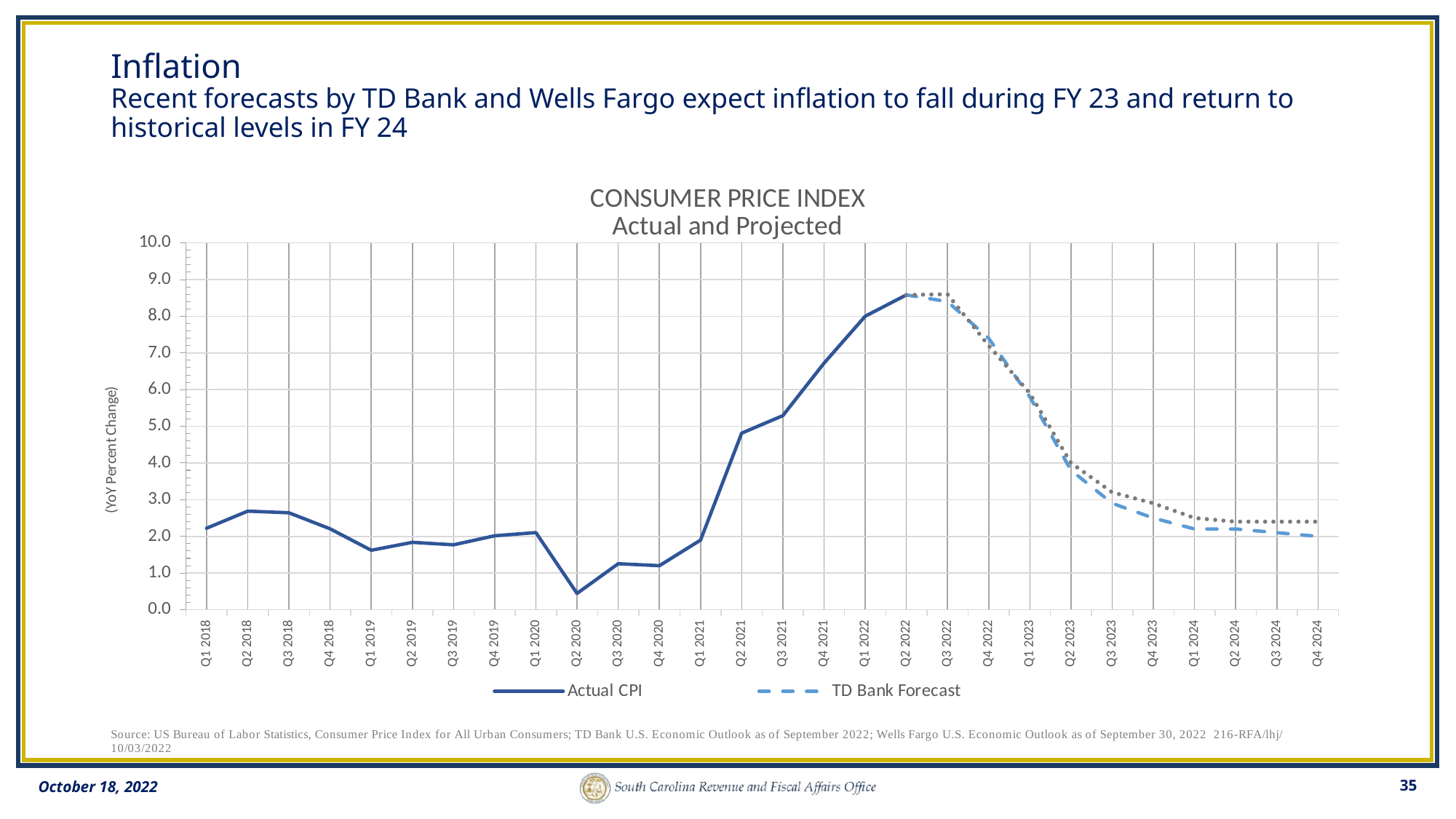
Does the Actual CPI line rise or fall between Q2 2020 and Q2 2022? Rise Is the TD Bank Forecast value for Q4 2024 greater or less than 3.0? less How many quarters are shown on the x axis? 28 Is the Actual CPI value for Q2 2020 greater or less than 1.0? less How many series does the legend list? 2 In which quarter does the Actual CPI line reach its lowest value? Q2 2020 In which quarter does the Actual CPI line reach its highest value? Q2 2022 Which is larger, the Actual CPI value for Q2 2018 or for Q1 2019? Q2 2018 Is the Actual CPI value for Q2 2022 greater or less than 8.0? greater What is the title of the chart? CONSUMER PRICE INDEX Actual and Projected What kind of chart is shown on the slide? Line chart